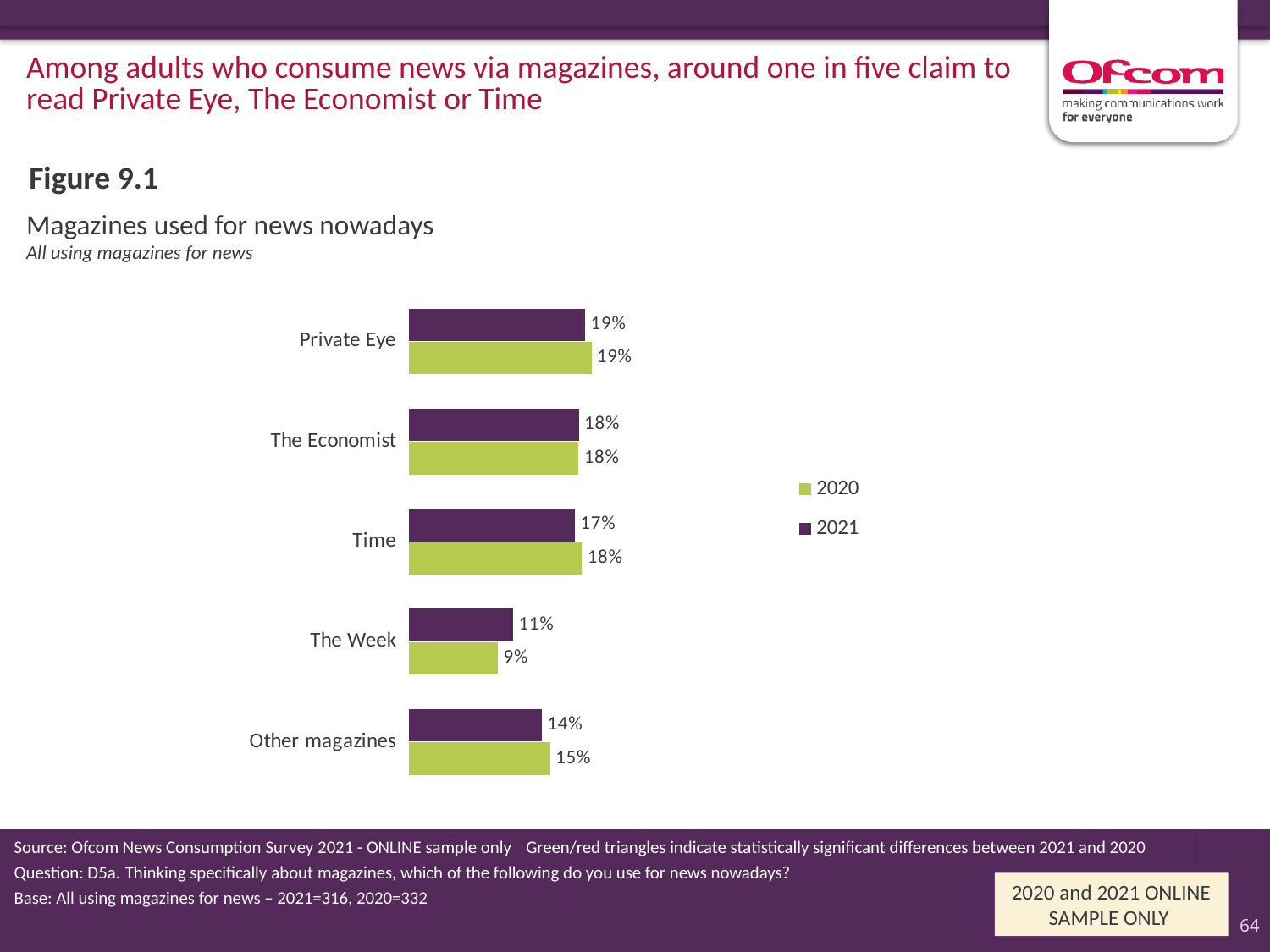
What is the 2020 value for Time? 18% What is the difference between the 2021 and 2020 values for The Week? 2 percentage points Is the 2020 value for Other magazines larger or smaller than the 2021 value for Other magazines? larger How many series does the legend list? 2 Which colour represents the 2021 series in the chart? Purple How many magazine categories are shown in the chart? 5 What is the 2021 value for Other magazines? 14% Which magazine has the lowest value in 2020? The Week What is the 2020 value for The Week? 9% Which magazine has the highest value in 2021? Private Eye What type of chart is shown on the slide? Bar chart What percentage of adults using magazines for news read Private Eye in 2021? 19%